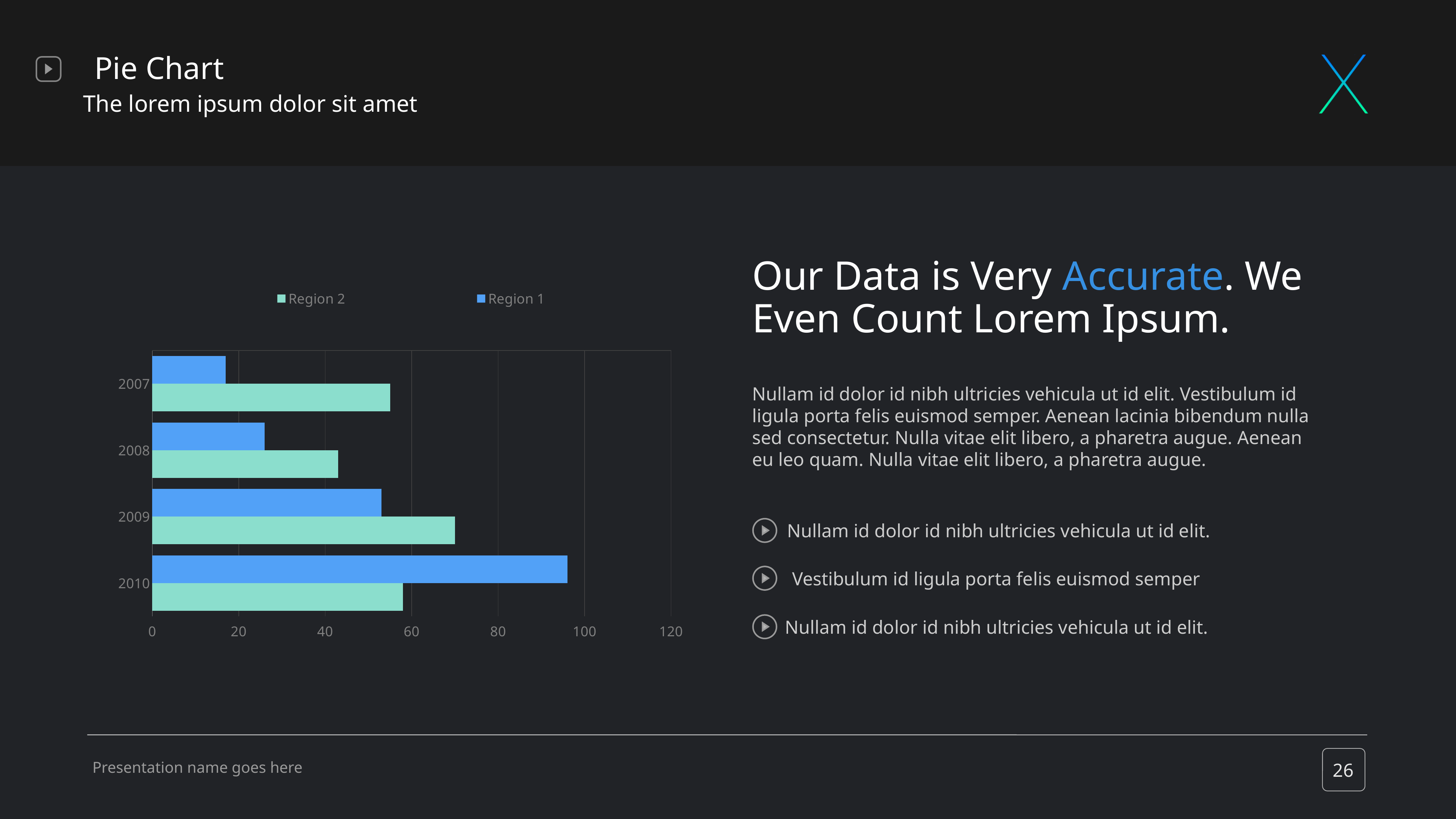
Is the value for Region 1 in 2010 greater or less than 80? greater How many year categories are plotted on the chart? 4 Do the Region 1 values rise or fall from 2007 to 2010? rise Is the value for Region 1 in 2007 greater or less than 20? less How many series does the chart's legend list? 2 In 2010, which series has the larger value, Region 1 or Region 2? Region 1 In 2007, which series has the larger value, Region 1 or Region 2? Region 2 Which year has the lowest value for Region 2? 2008 Which year has the highest value for Region 1? 2010 What kind of chart is shown on the slide? bar chart Which year has the highest value for Region 2? 2009 Which year has the lowest value for Region 1? 2007